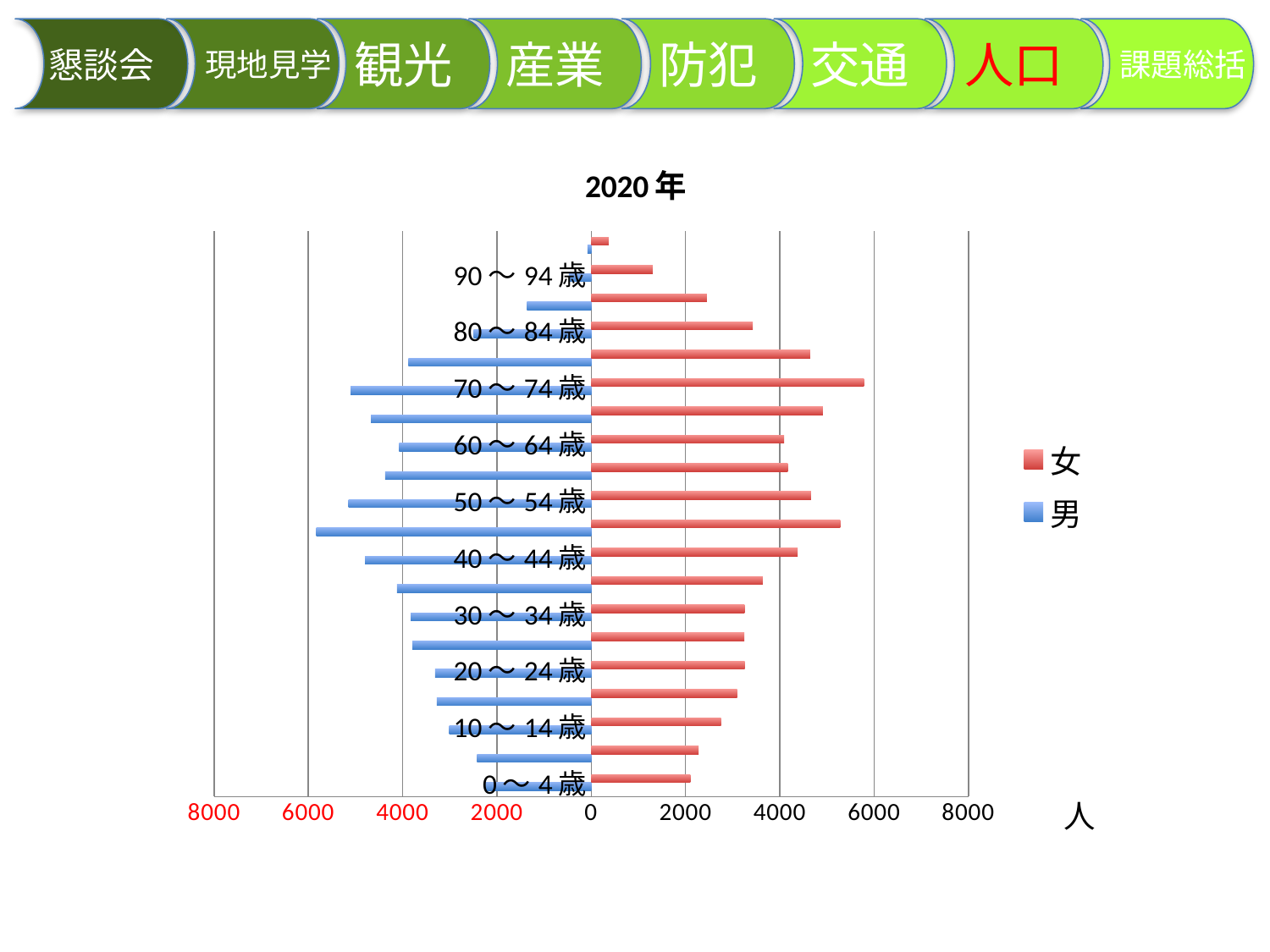
How many series does the legend list? 2 Do the values for 女 rise or fall from the 70〜74歳 group to the 90〜94歳 group? fall What kind of chart is shown on the slide? bar chart Is the value for 男 in the 50〜54歳 group greater or less than 4000? greater Which age group has the highest value for 女? 70〜74歳 Which series is shown in red according to the legend? 女 Is the value for 女 in the 70〜74歳 group greater or less than 4000? greater Is the value for 女 in the 0〜4歳 group greater or less than 4000? less Which is larger for 女: the 80〜84歳 group or the 90〜94歳 group? 80〜84歳 What is the title of the chart? 2020年